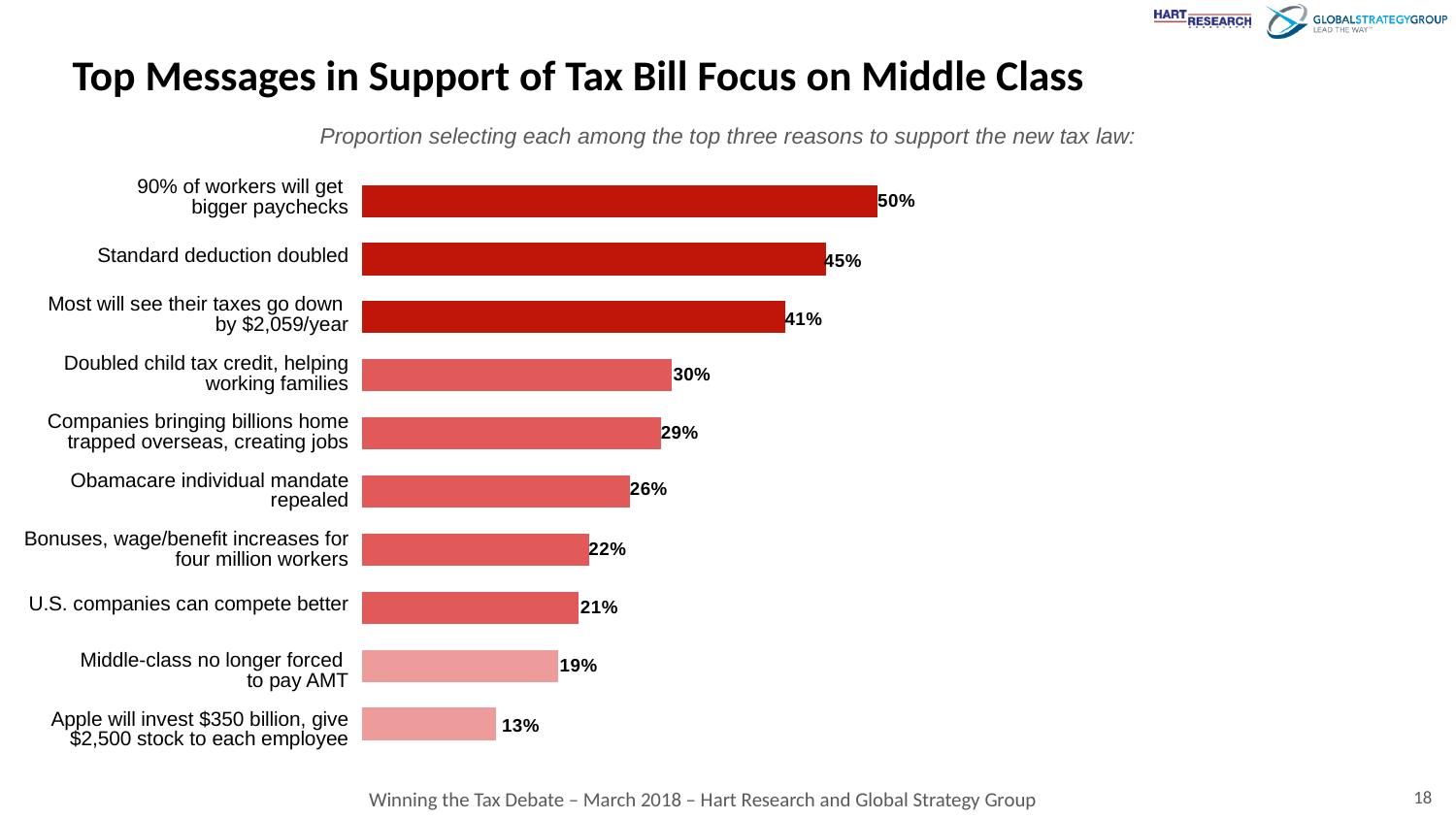
Which message has the highest proportion? 90% of workers will get bigger paychecks How many messages are shown in the chart? 10 What kind of chart is shown on the slide? Bar chart What proportion selected "Obamacare individual mandate repealed"? 26% What is the value for "Middle-class no longer forced to pay AMT"? 19% What is the value for "Standard deduction doubled"? 45% What is the difference between "Doubled child tax credit, helping working families" and "Apple will invest $350 billion, give $2,500 stock to each employee"? 17% Which message has the lowest proportion? Apple will invest $350 billion, give $2,500 stock to each employee Which is larger: the value for "Most will see their taxes go down by $2,059/year" or "Companies bringing billions home trapped overseas, creating jobs"? Most will see their taxes go down by $2,059/year What proportion selected "90% of workers will get bigger paychecks" among their top three reasons? 50% What is the title of the slide? Top Messages in Support of Tax Bill Focus on Middle Class What is the difference between the values for "90% of workers will get bigger paychecks" and "Standard deduction doubled"? 5%